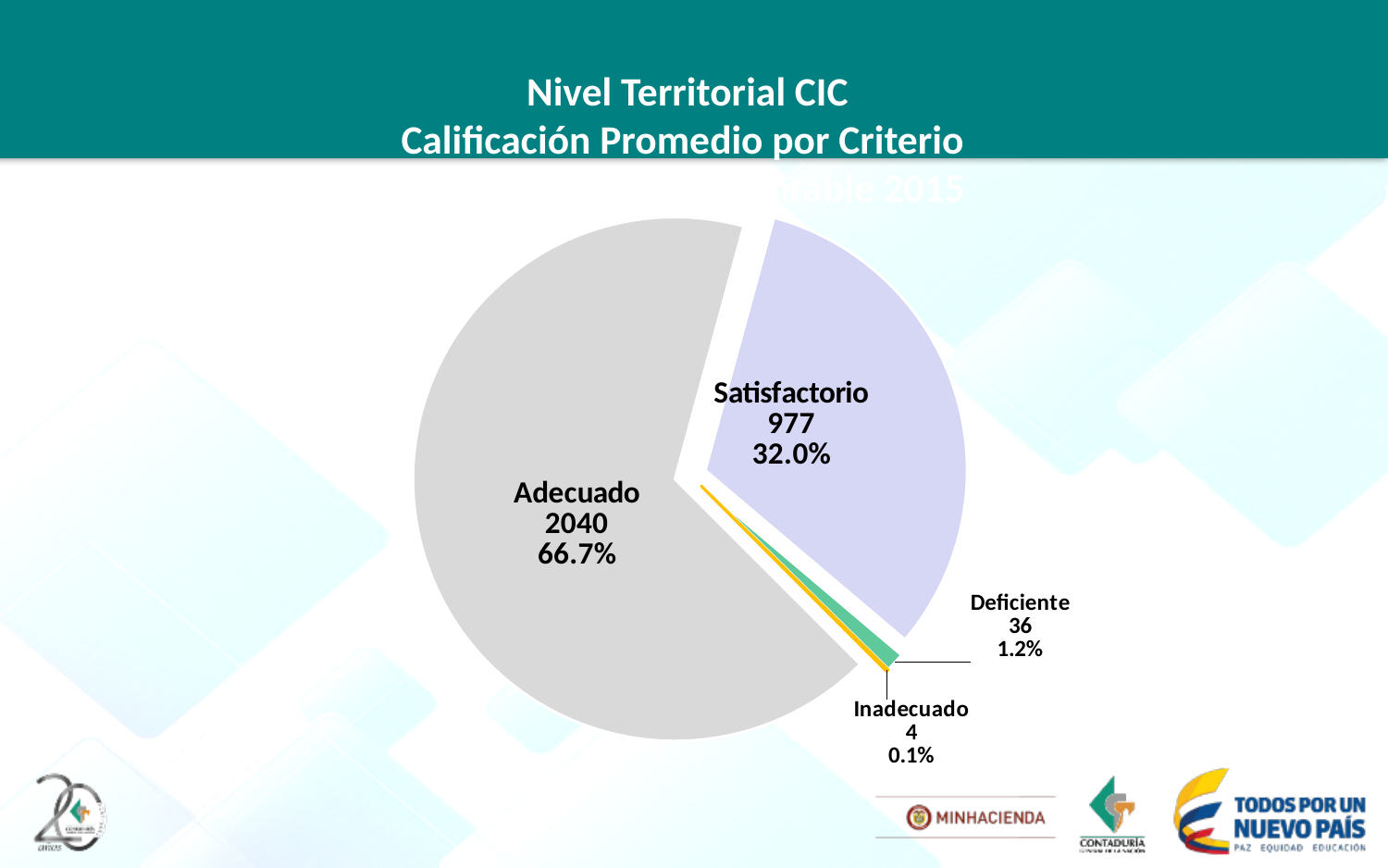
What share of the pie does Adecuado represent? 66.7% Which is larger, the value for Deficiente or the value for Inadecuado? Deficiente What is the value for Deficiente? 36 Which category has the largest slice? Adecuado What share of the pie does Satisfactorio represent? 32.0% What is the value for Adecuado? 2040 Which category has the smallest slice? Inadecuado How many categories are shown in the pie chart? 4 What is the value for Satisfactorio? 977 What kind of chart is shown on the slide? pie chart What is the value for Inadecuado? 4 What is the difference between the values for Adecuado and Satisfactorio? 1063